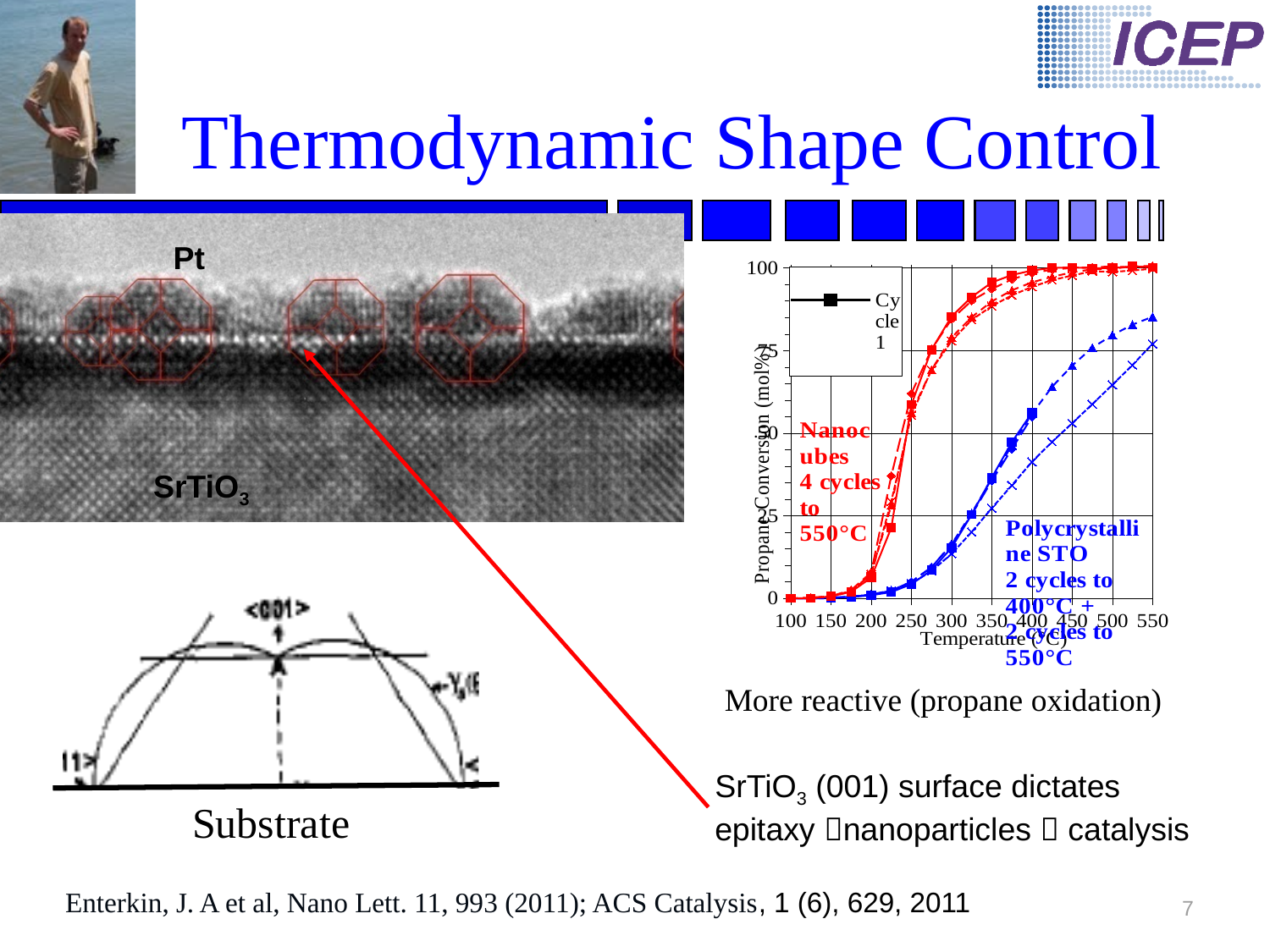
Does propane conversion rise or fall as temperature increases along the x axis? rise Which series shows higher propane conversion at 400°C, Nanocubes (red) or Polycrystalline STO (blue)? Nanocubes (red) How many temperature tick labels are shown on the x axis of the chart? 10 Is the propane conversion for the Nanocubes (red) series at 200°C greater or less than 25? less What kind of chart is shown on the right of the slide? line chart Is the propane conversion for the Nanocubes (red) series at 300°C greater or less than 75? greater Is the propane conversion for the Polycrystalline STO (blue) series at 550°C greater or less than 50? greater What is the label of the x axis of the chart? Temperature (°C) What is the highest value shown on the y axis of the chart? 100 What is the label of the y axis of the chart? Propane Conversion (mol%)